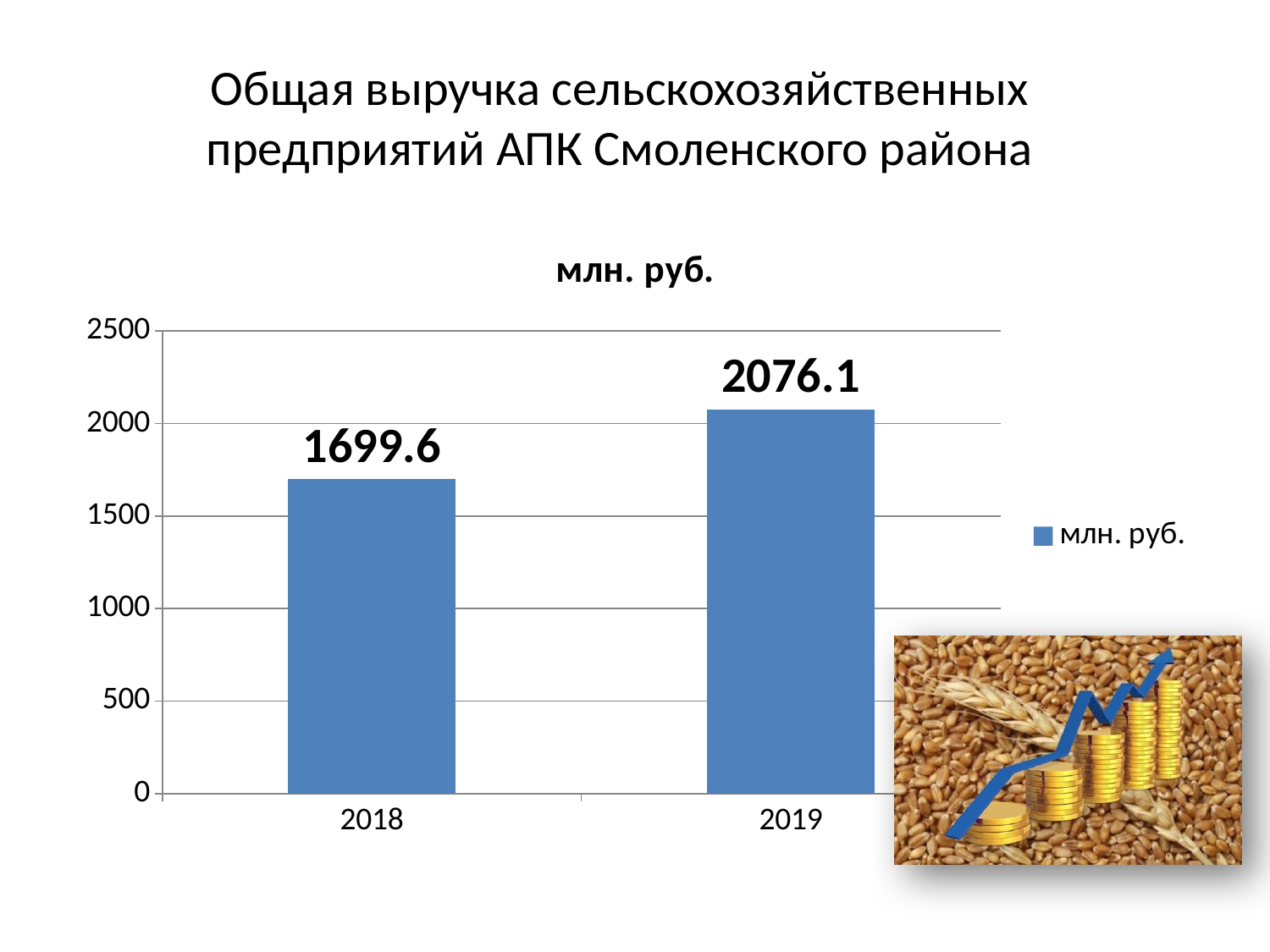
What is the difference between the values for 2019 and 2018? 376.5 What is the value for 2019? 2076.1 How many years are shown on the chart? 2 Which year has the lowest value? 2018 Is the value for 2019 greater or less than 2000? greater What is the value for 2018? 1699.6 Which is larger, the value for 2018 or the value for 2019? 2019 Which year has the highest value? 2019 How many series does the legend list? 1 What kind of chart is shown on the slide? bar chart Do the values rise or fall from 2018 to 2019? rise Is the value for 2018 greater or less than 2000? less